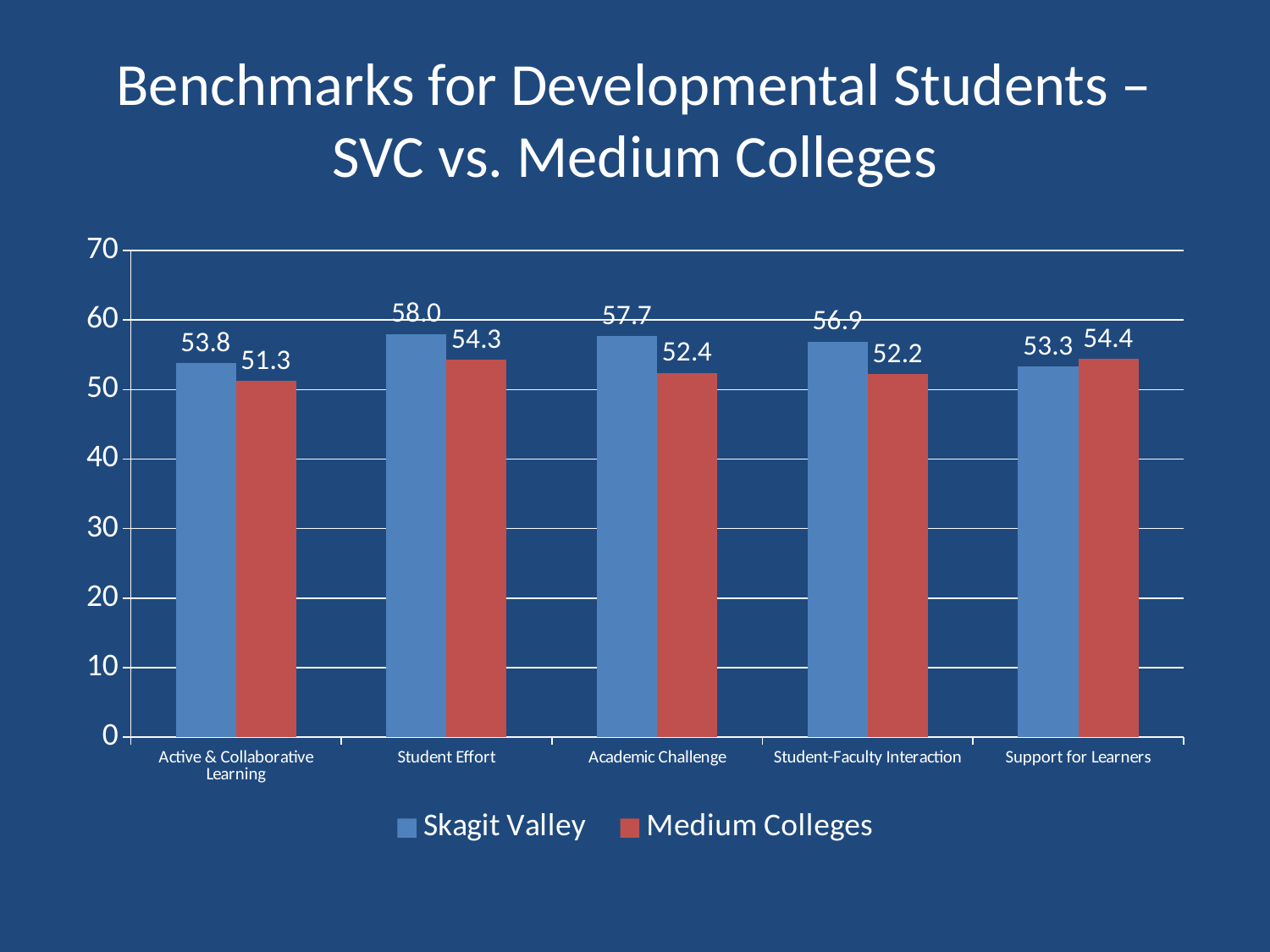
How many categories are shown on the x axis? 5 What kind of chart is shown on the slide? Bar chart What is the Medium Colleges value for Support for Learners? 54.4 Which category has the lowest Medium Colleges value? Active & Collaborative Learning What is the Skagit Valley value for Student Effort? 58.0 What is the difference between the Skagit Valley and Medium Colleges values for Academic Challenge? 5.3 Is the Skagit Valley value for Student-Faculty Interaction greater or less than 50? greater What colour are the Medium Colleges bars? Red For Support for Learners, which is larger: Skagit Valley or Medium Colleges? Medium Colleges Which category has the highest Skagit Valley value? Student Effort What is the Medium Colleges value for Active & Collaborative Learning? 51.3 How many series does the legend list? 2